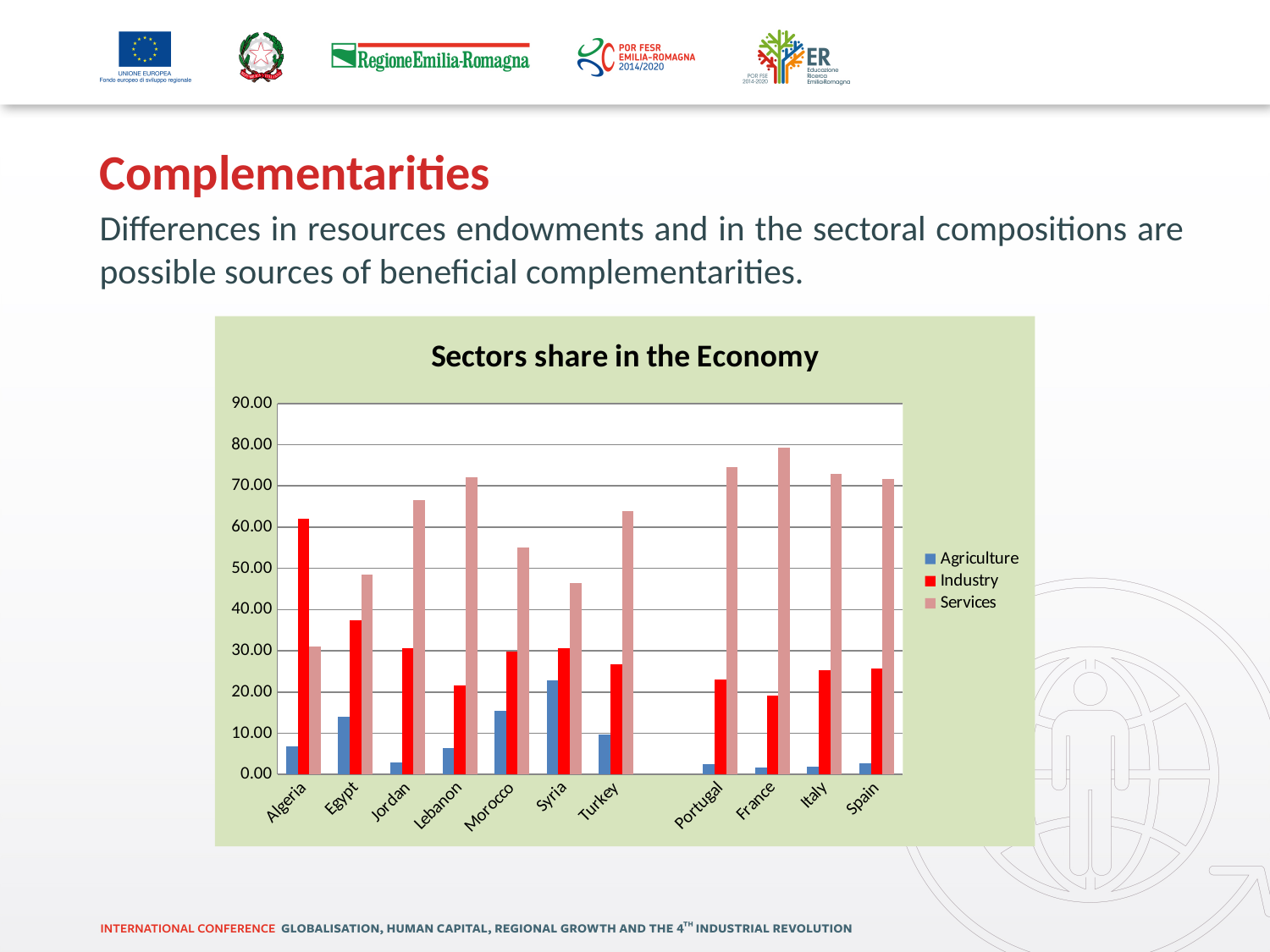
How many series does the legend list? 3 Which country has the highest Agriculture share? Syria Is the Services value for Morocco greater or less than 50.00? greater Which country has the highest Industry share? Algeria Is the Industry value for Algeria greater or less than 60.00? greater Which country has the lowest Services share? Algeria How many countries are labeled on the x axis? 11 Which series is shown in red in the legend? Industry What kind of chart is shown on the slide? bar chart What is the title of the chart? Sectors share in the Economy Which country has the highest Services share? France For Algeria, which is larger: the Industry share or the Services share? Industry